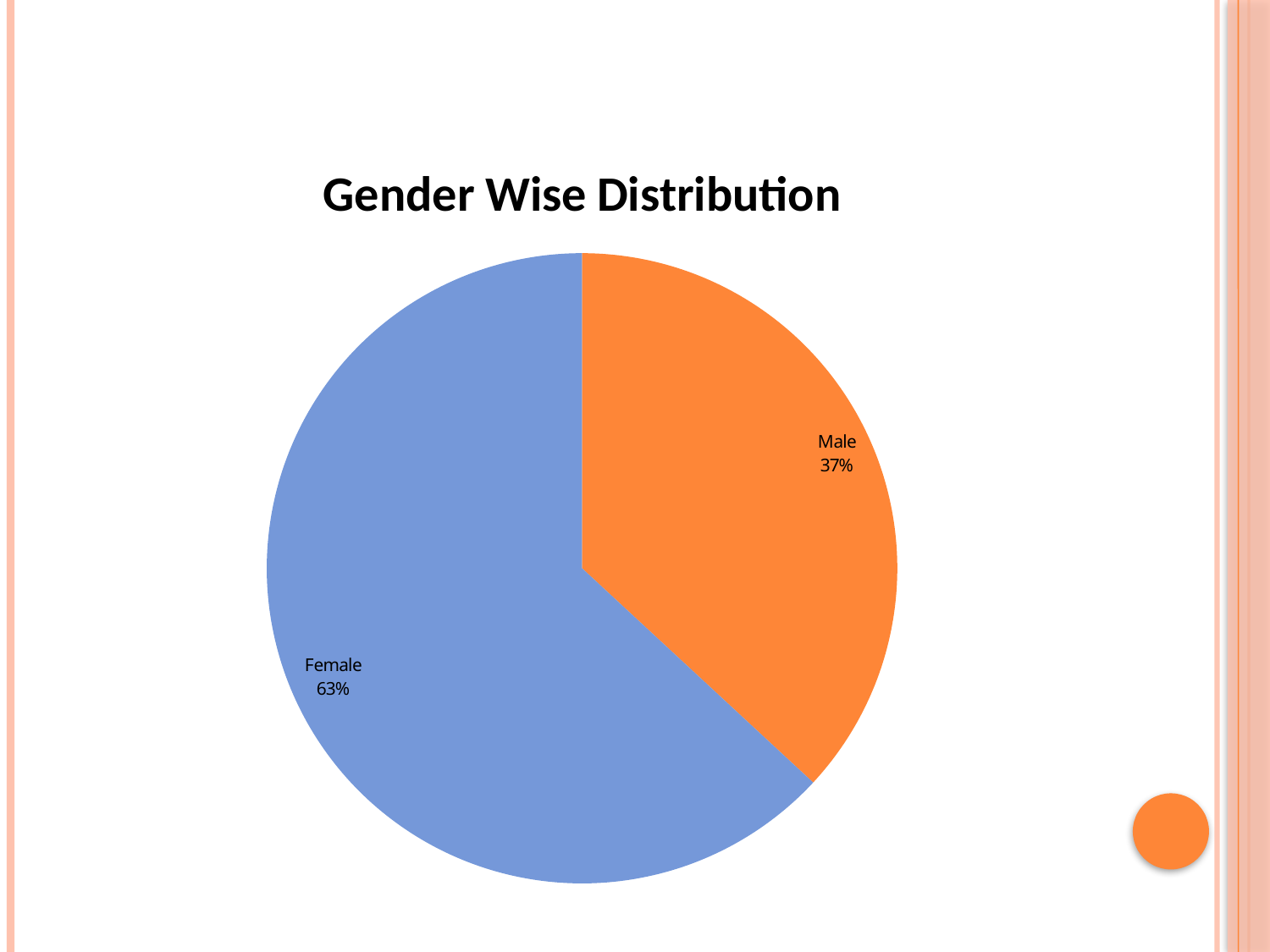
What is the share of the pie taken by the Female slice? 63% What kind of chart is shown on the slide? pie chart What is the difference in percentage points between the Female and Male shares? 26 What percentage of the pie is Female? 63% Which is larger, the Female share or the Male share? Female What colour is the Male slice? orange What percentage of the pie is Male? 37% Which category has the smallest share of the pie? Male What is the title of the chart? Gender Wise Distribution How many slices does the pie chart have? 2 Which category has the largest share of the pie? Female